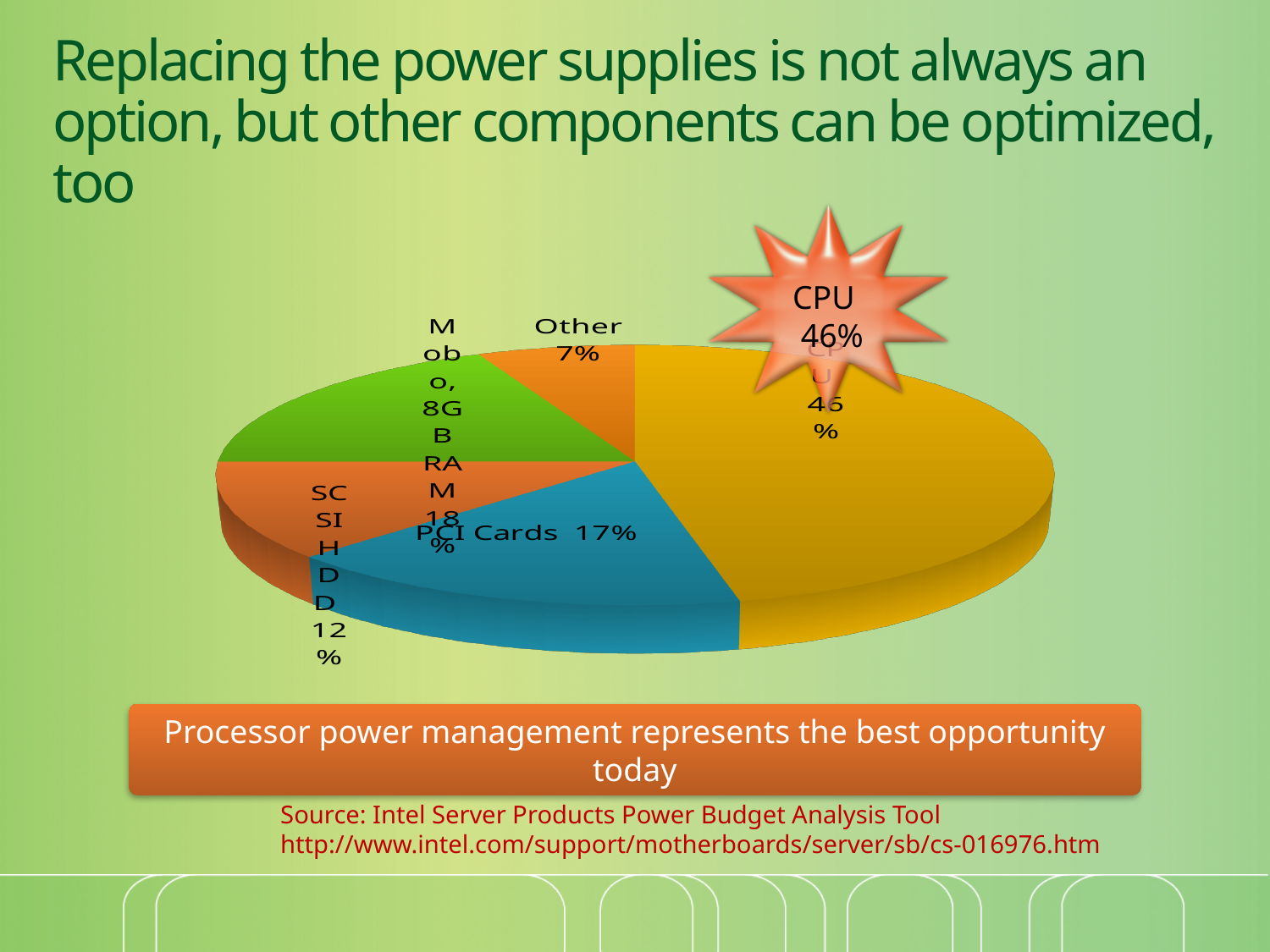
What share of the pie does SCSI HDD represent? 12% What colour is the CPU slice of the pie? yellow Which is larger, the SCSI HDD slice or the Mobo, 8GB RAM slice? Mobo, 8GB RAM What share of the pie does Mobo, 8GB RAM represent? 18% What kind of chart is shown on the slide? pie chart Which slice of the pie is the smallest? Other What share of the pie does PCI Cards represent? 17% How many slices does the pie chart have? 5 What share of the pie does Other represent? 7% Which slice of the pie is the largest? CPU What is the difference in percentage points between the CPU slice and the PCI Cards slice? 29 What share of the pie does CPU represent? 46%